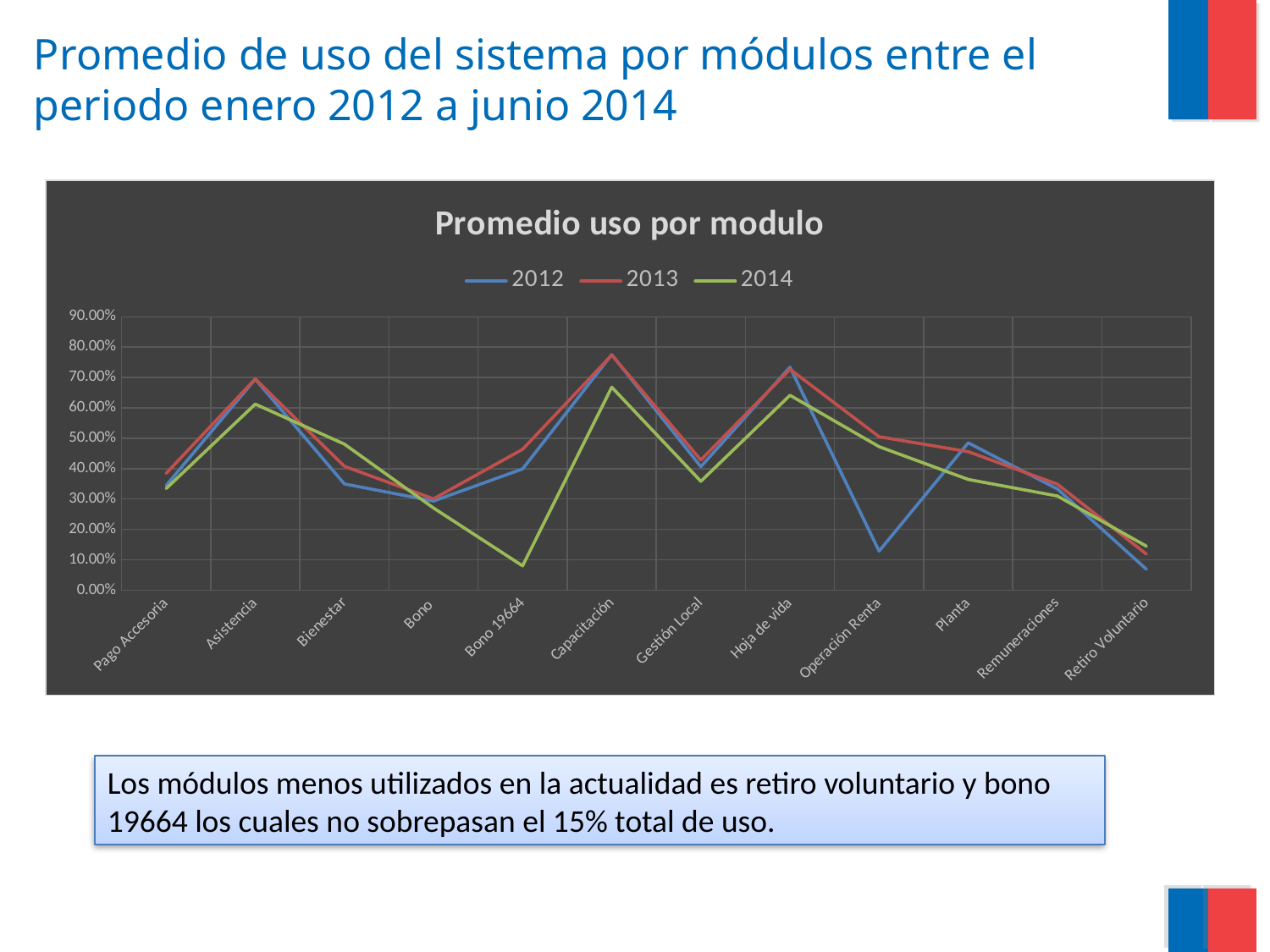
What kind of chart is shown on the slide? Line chart For Operación Renta, which series has the larger value, 2012 or 2013? 2013 How many modules (categories) are plotted along the x axis? 12 Does the 2014 series rise or fall from Planta to Retiro Voluntario? Fall What is the title of the chart? Promedio uso por modulo Which module has the lowest value for the 2012 series? Retiro Voluntario How many series does the legend of the chart list? 3 Is the 2014 value for Bono 19664 greater or less than 20.00%? less Which module has the highest value for the 2012 series? Capacitación Which module has the lowest value for the 2014 series? Bono 19664 Is the 2013 value for Capacitación greater or less than 70.00%? greater Is the 2012 value for Operación Renta greater or less than 20.00%? less